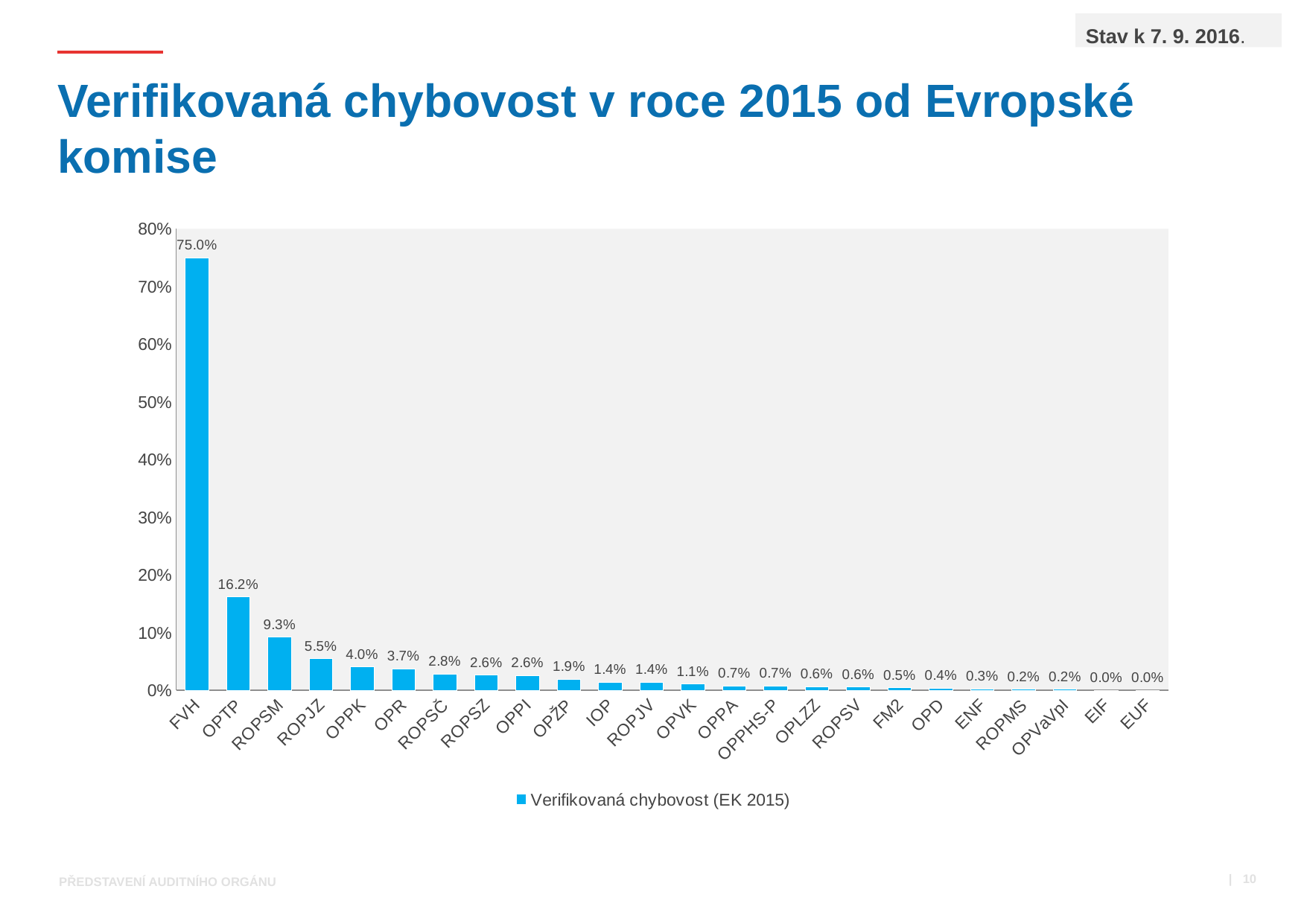
What is the difference between the values for OPTP and ROPSM? 6.9% How many series does the legend list? 1 What kind of chart is shown on the slide? bar chart Which category has the highest value? FVH What is the difference between the values for FVH and OPTP? 58.8% Which is larger, the value for ROPJZ or the value for OPPK? ROPJZ What is the value for OPTP? 16.2% What is the value for ROPSM? 9.3% How many categories are shown on the x axis? 24 Is the value for FVH greater or less than 70%? greater What is the value for OPVK? 1.1% What is the value for FVH? 75.0%